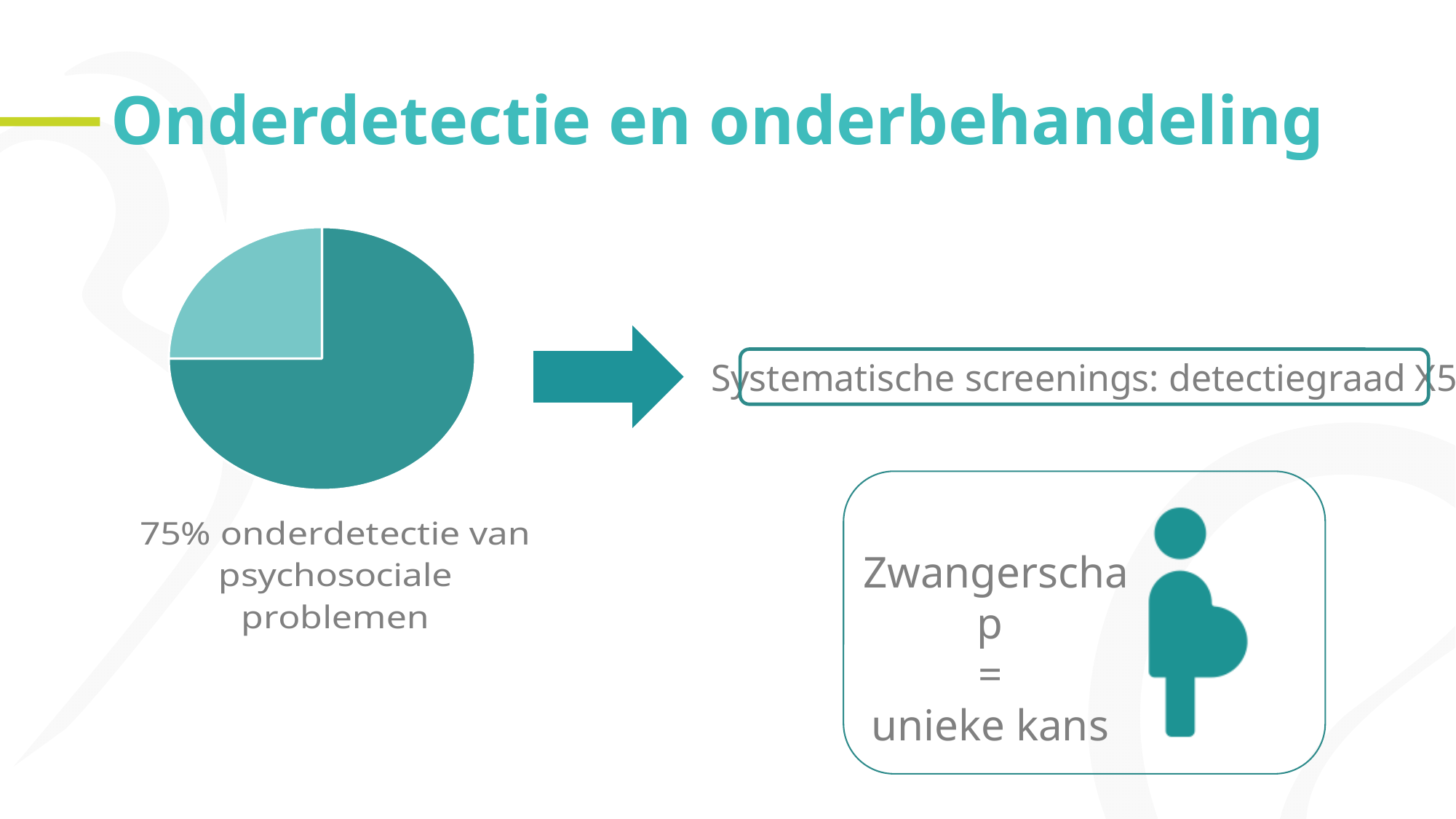
How many slices does the pie chart have? 2 Which slice of the pie chart is larger, the dark teal slice or the light teal slice? the dark teal slice What share of the pie does the dark teal slice represent, according to the caption under the chart? 75% What kind of chart is shown on the slide? pie chart Does the pie chart have a legend? No What percentage of underdetection of psychosocial problems does the caption under the pie chart state? 75% What is the caption written under the pie chart? 75% onderdetectie van psychosociale problemen Which slice of the pie chart is the smallest? the light teal slice Is the share of the dark teal slice in the pie chart greater or less than 50%? greater Is the share of the light teal slice in the pie chart greater or less than 50%? less